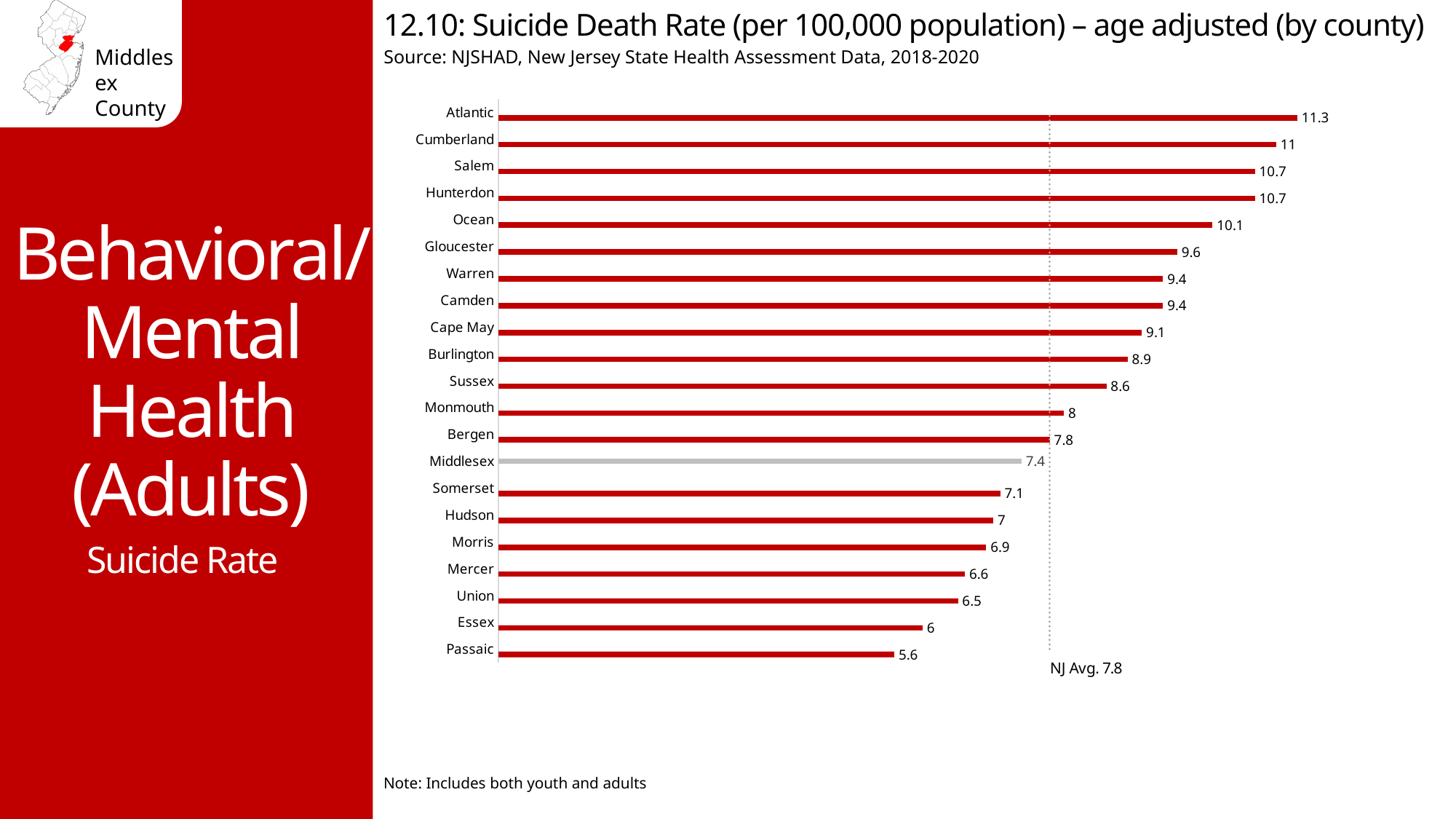
Which county has the highest suicide death rate? Atlantic What is the suicide death rate for Passaic County? 5.6 What type of chart is shown on the slide? Bar chart What is the suicide death rate for Atlantic County? 11.3 Which county has the lowest suicide death rate? Passaic Which county's bar is shown in gray instead of red? Middlesex Which has a higher suicide death rate, Ocean or Gloucester? Ocean What is the NJ average suicide death rate shown on the chart? 7.8 What is the difference between the suicide death rates of Atlantic and Passaic counties? 5.7 What is the suicide death rate for Middlesex County? 7.4 How many counties are shown in the chart? 21 What is the difference between the NJ average and the Middlesex County suicide death rate? 0.4